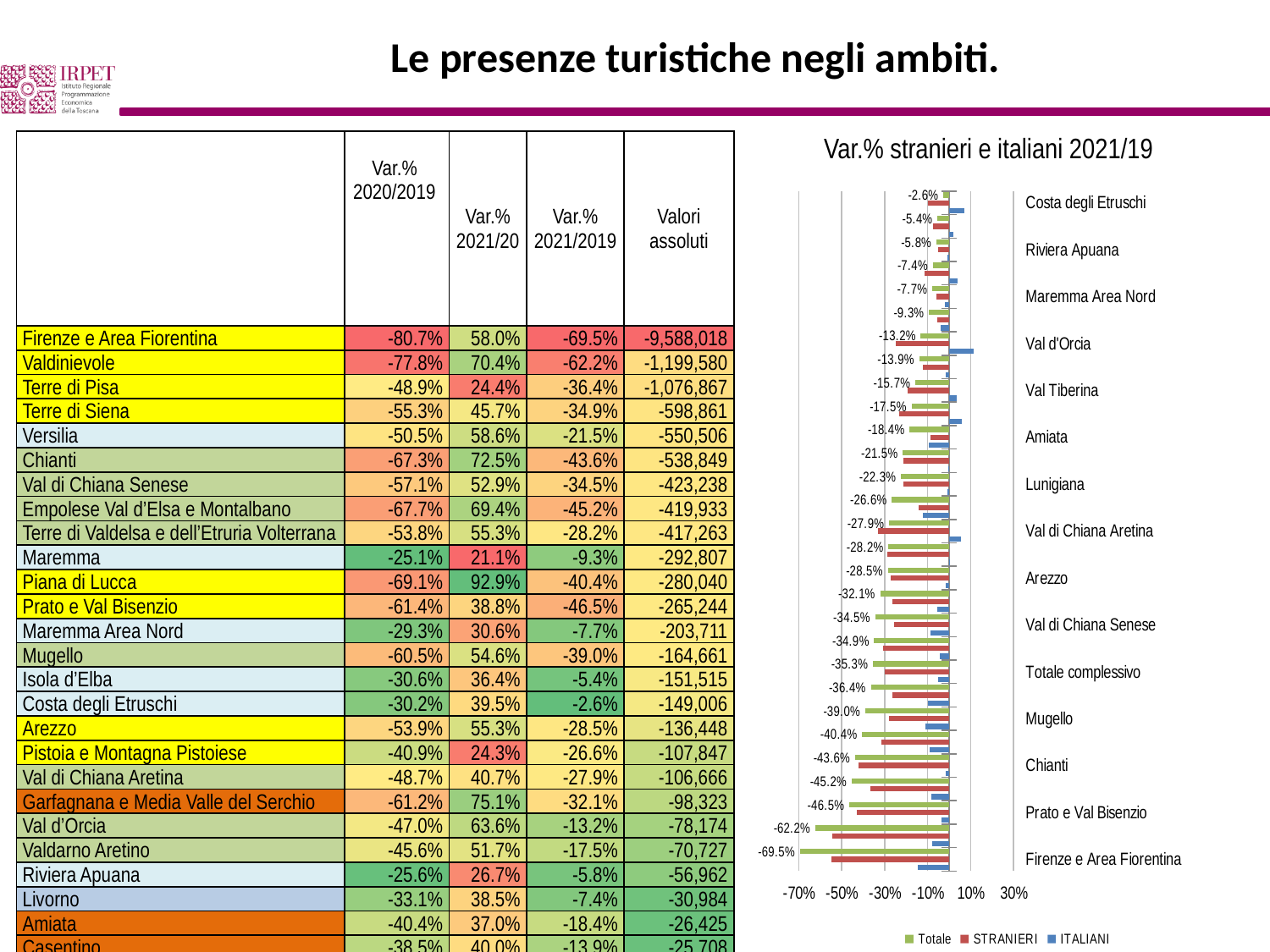
Which category has the highest (least negative) Totale value in the chart? Costa degli Etruschi What is the title of the chart on the right of the slide? Var.% stranieri e italiani 2021/19 What kind of chart is shown on the right of the slide? bar chart Which category has the lowest (most negative) Totale value in the chart? Firenze e Area Fiorentina In the chart, what is the Totale value labelled for Costa degli Etruschi? -2.6% In the chart, is the Totale value for Totale complessivo greater or less than -30%? less In the chart, which has the larger Totale value: Costa degli Etruschi or Firenze e Area Fiorentina? Costa degli Etruschi In the chart, what is the Totale value labelled for Firenze e Area Fiorentina? -69.5% How many series does the legend of the chart list? 3 What is the difference in percentage points between the Totale values for Costa degli Etruschi (-2.6%) and Firenze e Area Fiorentina (-69.5%)? 66.9 percentage points In the chart, what is the Totale value labelled for Mugello? -39.0% What are the three series named in the chart's legend? Totale, STRANIERI, ITALIANI